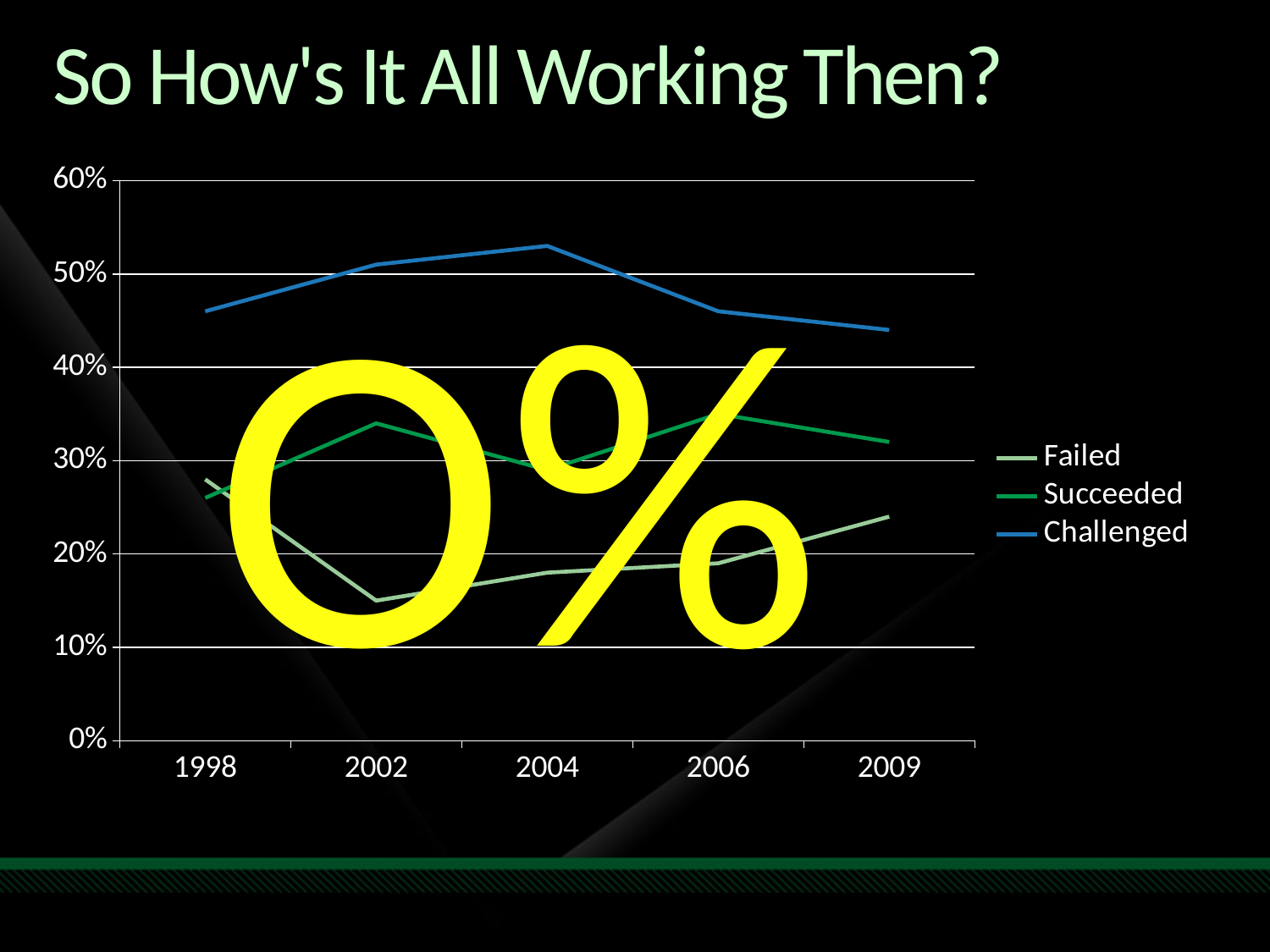
What kind of chart is shown on the slide? line chart Is the value for Succeeded in 2009 greater or less than 30%? greater Is the value for Failed in 2002 greater or less than 20%? less How many years are shown on the x axis? 5 Which series has the higher value in 2006, Failed or Challenged? Challenged In which year does the Failed series reach its lowest value? 2002 What is the title of the slide? So How's It All Working Then? Is the value for Challenged in 2004 greater or less than 50%? greater In which year does the Challenged series reach its highest value? 2004 How many series does the legend list? 3 Does the Challenged series rise or fall from 2004 to 2009? fall